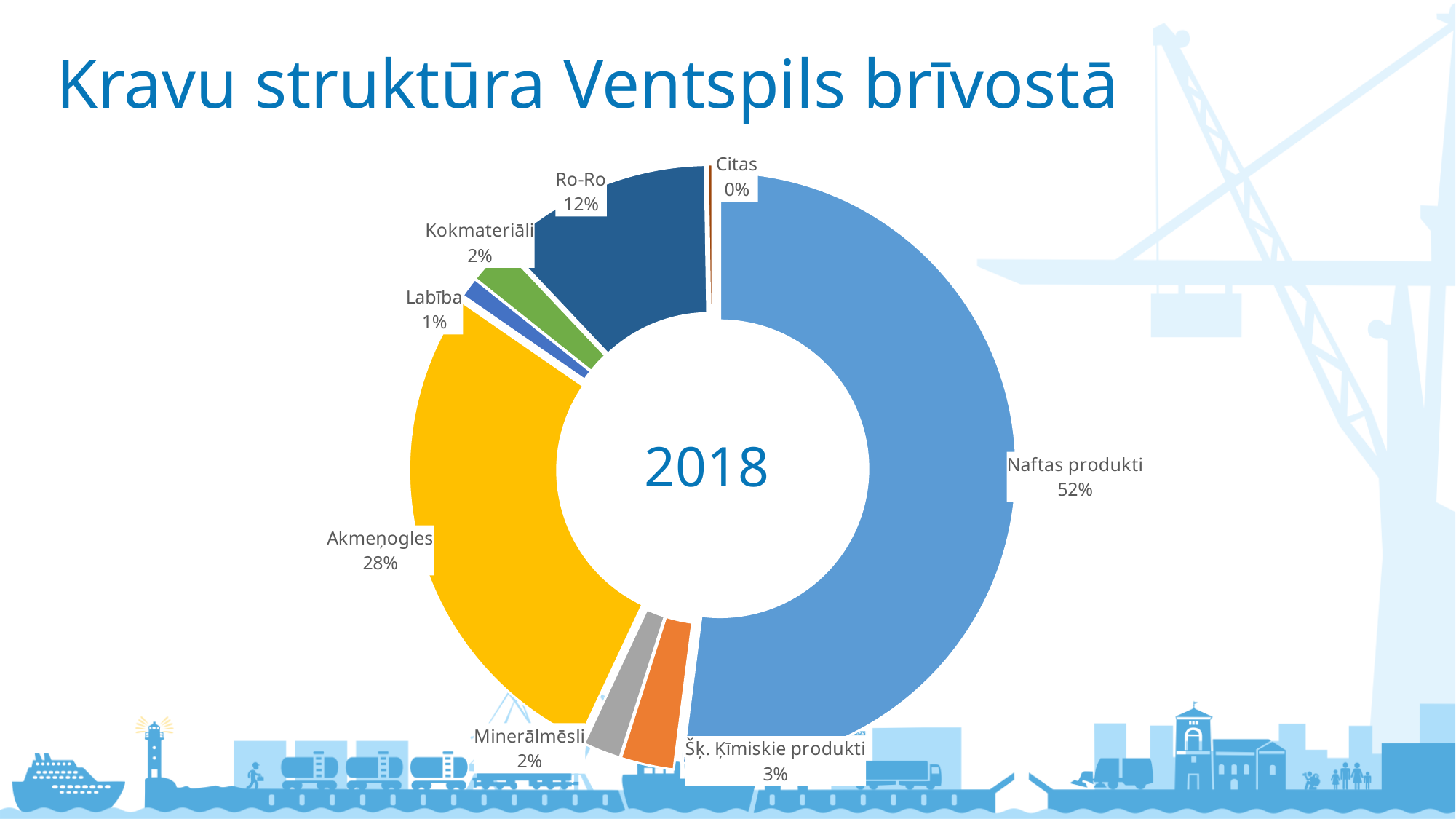
What year is written in the centre of the chart? 2018 What percentage is shown for Šķ. Ķīmiskie produkti? 3% What kind of chart is shown on the slide? Doughnut (pie) chart What percentage is shown for Akmeņogles? 28% Which category has the smallest share of the chart? Citas What is the value labelled for Ro-Ro? 12% Which is larger, the share for Ro-Ro or the share for Šķ. Ķīmiskie produkti? Ro-Ro What is the difference in percentage points between Naftas produkti and Akmeņogles? 24 What share of the chart does Naftas produkti account for? 52% How many categories are shown in the chart? 8 Which category has the largest share of the chart? Naftas produkti What percentage is shown for Labība? 1%